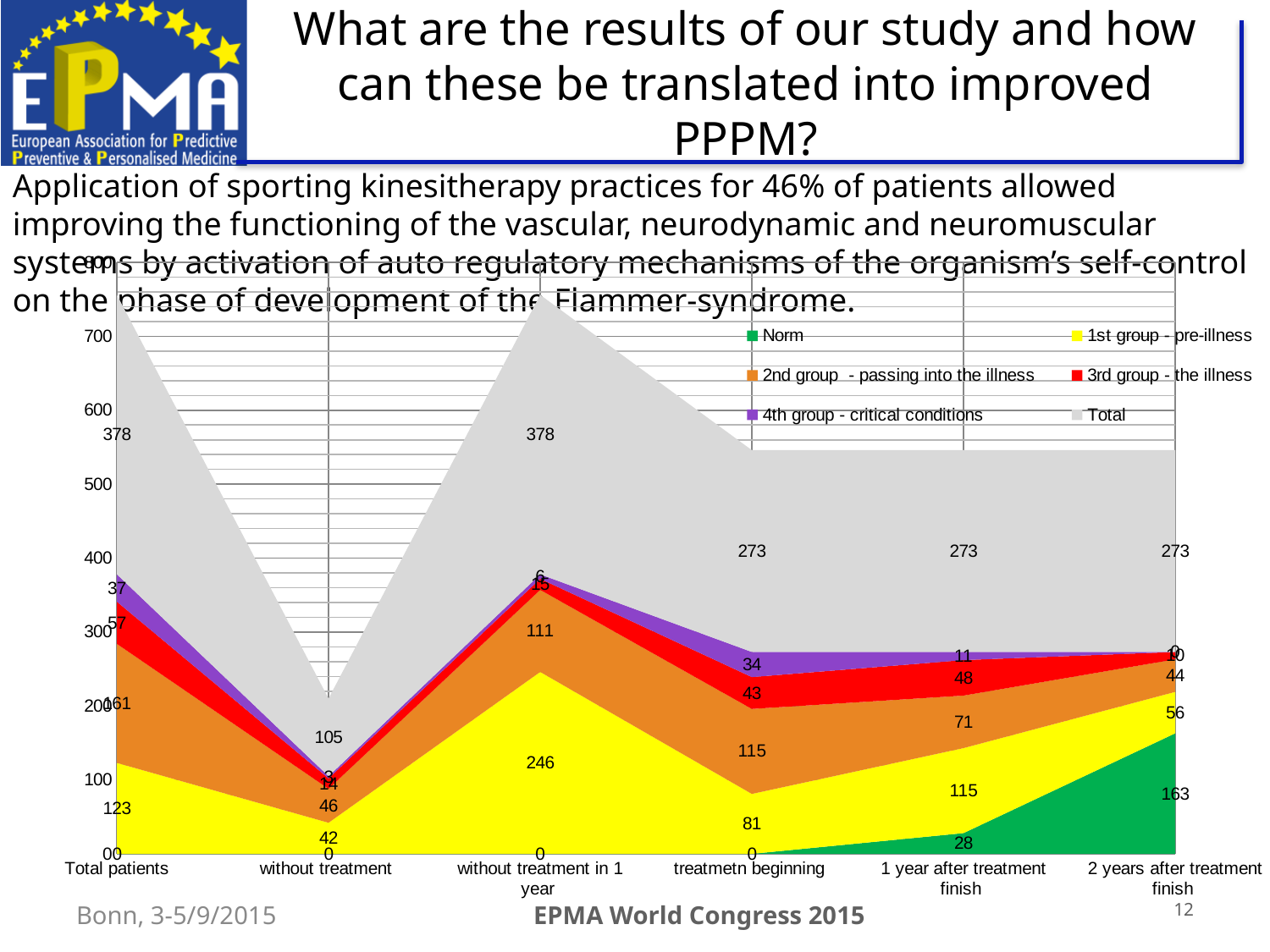
How many series does the chart legend list? 6 Which is larger: the Norm value at '1 year after treatment finish' or at '2 years after treatment finish'? 2 years after treatment finish Which legend entry is shown in green? Norm What is the Total value for 'without treatment'? 105 What is the Total value for the 'Total patients' category? 378 What is the value of the 2nd group - passing into the illness series at 'treatmetn beginning'? 115 What is the value of the 1st group - pre-illness series for 'without treatment in 1 year'? 246 What is the difference between the Total for 'Total patients' and the Total for 'treatmetn beginning'? 105 What is the Norm value for '2 years after treatment finish'? 163 How many categories are shown along the x axis of the chart? 6 What kind of chart is shown on the slide? Stacked area chart Which category has the lowest Total value? without treatment